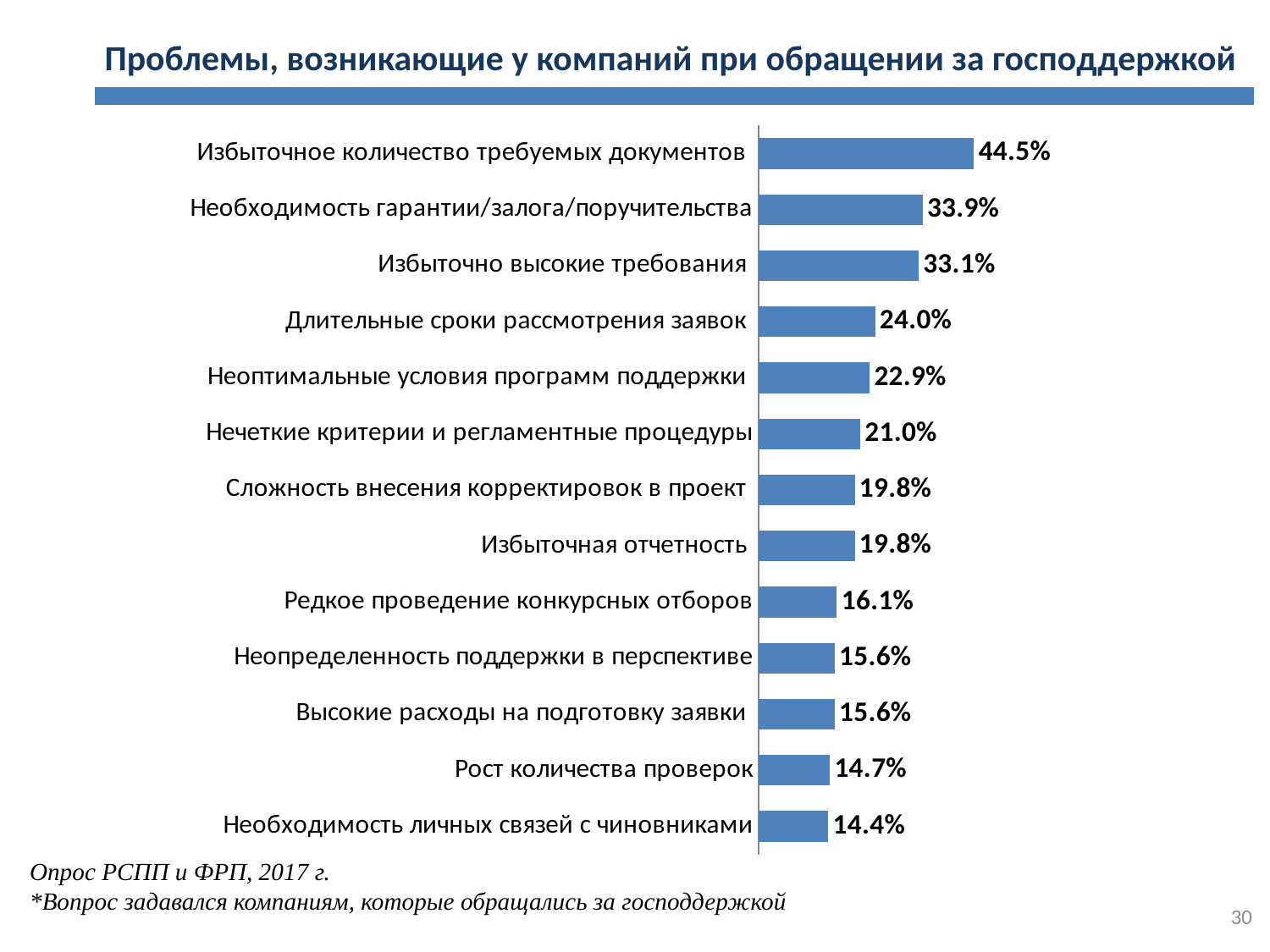
What kind of chart is shown on the slide? Bar chart What is the value for "Избыточное количество требуемых документов"? 44.5% What is the value for "Рост количества проверок"? 14.7% What is the difference between the values for "Избыточное количество требуемых документов" and "Необходимость гарантии/залога/поручительства"? 10.6 percentage points How many categories are shown in the chart? 13 Which category has the lowest value? Необходимость личных связей с чиновниками What is the value for "Длительные сроки рассмотрения заявок"? 24.0% What is the title of the slide? Проблемы, возникающие у компаний при обращении за господдержкой Which is larger: the value for "Необходимость гарантии/залога/поручительства" or for "Избыточно высокие требования"? Необходимость гарантии/залога/поручительства Which category has the highest value? Избыточное количество требуемых документов Do the values rise or fall going from the top bar to the bottom bar? Fall What is the value for "Избыточная отчетность"? 19.8%